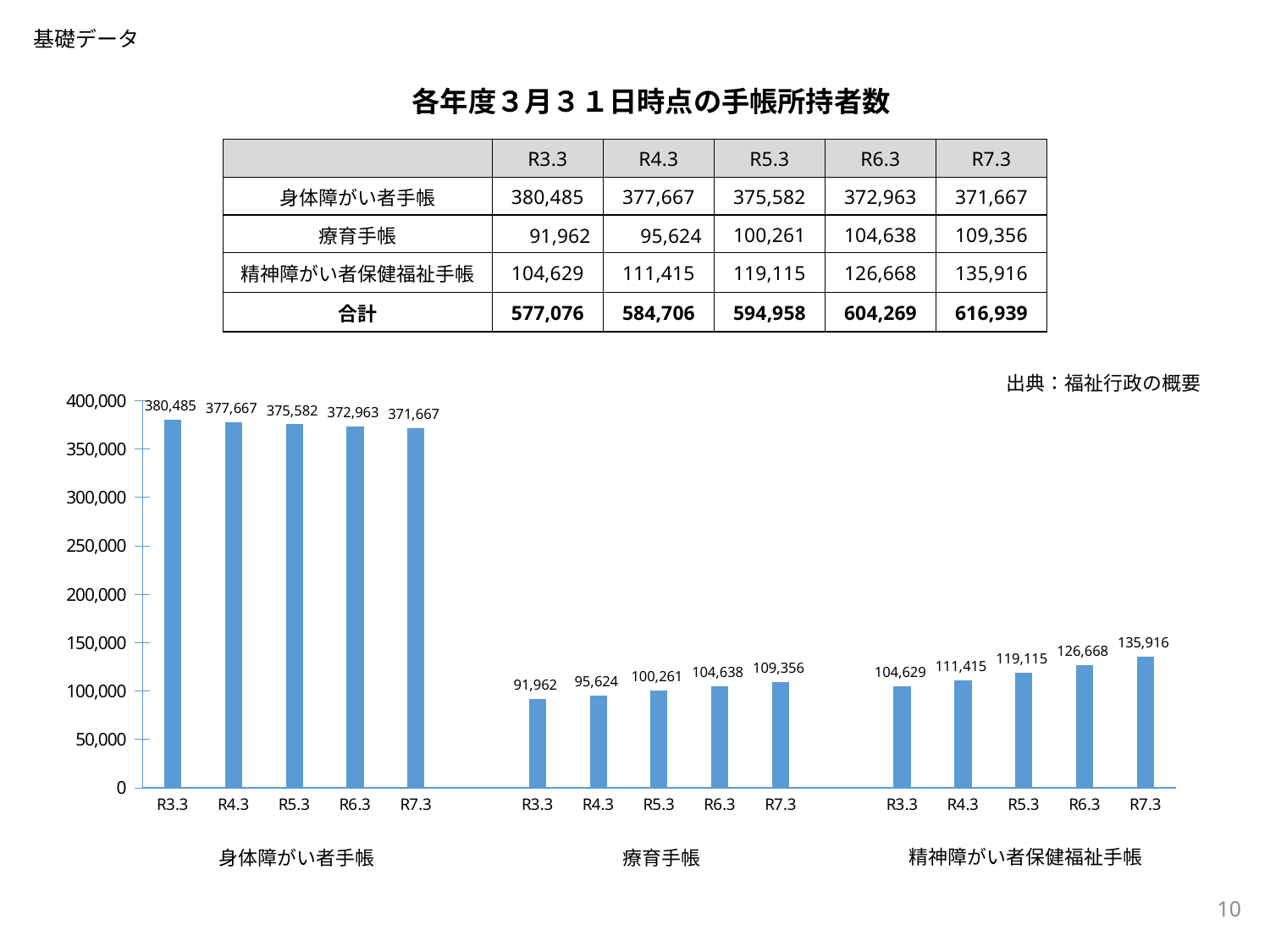
Is the R4.3 value for 療育手帳 greater or less than 100,000? less What is the difference between the R3.3 and R7.3 values in the 身体障がい者手帳 group? 8,818 Which is larger: the R7.3 value for 療育手帳 or the R3.3 value for 精神障がい者保健福祉手帳? R7.3 value for 療育手帳 Which year has the highest value in the 精神障がい者保健福祉手帳 group? R7.3 Do the values in the 身体障がい者手帳 group rise or fall from R3.3 to R7.3? fall What is the value for R5.3 in the 療育手帳 group? 100,261 Which year has the lowest value in the 療育手帳 group? R3.3 What is the title of the chart? 各年度３月３１日時点の手帳所持者数 What is the value for R6.3 in the 精神障がい者保健福祉手帳 group? 126,668 What kind of chart is shown on the slide? bar chart What is the value for R7.3 in the 身体障がい者手帳 group? 371,667 How many bars are plotted in total on the chart? 15